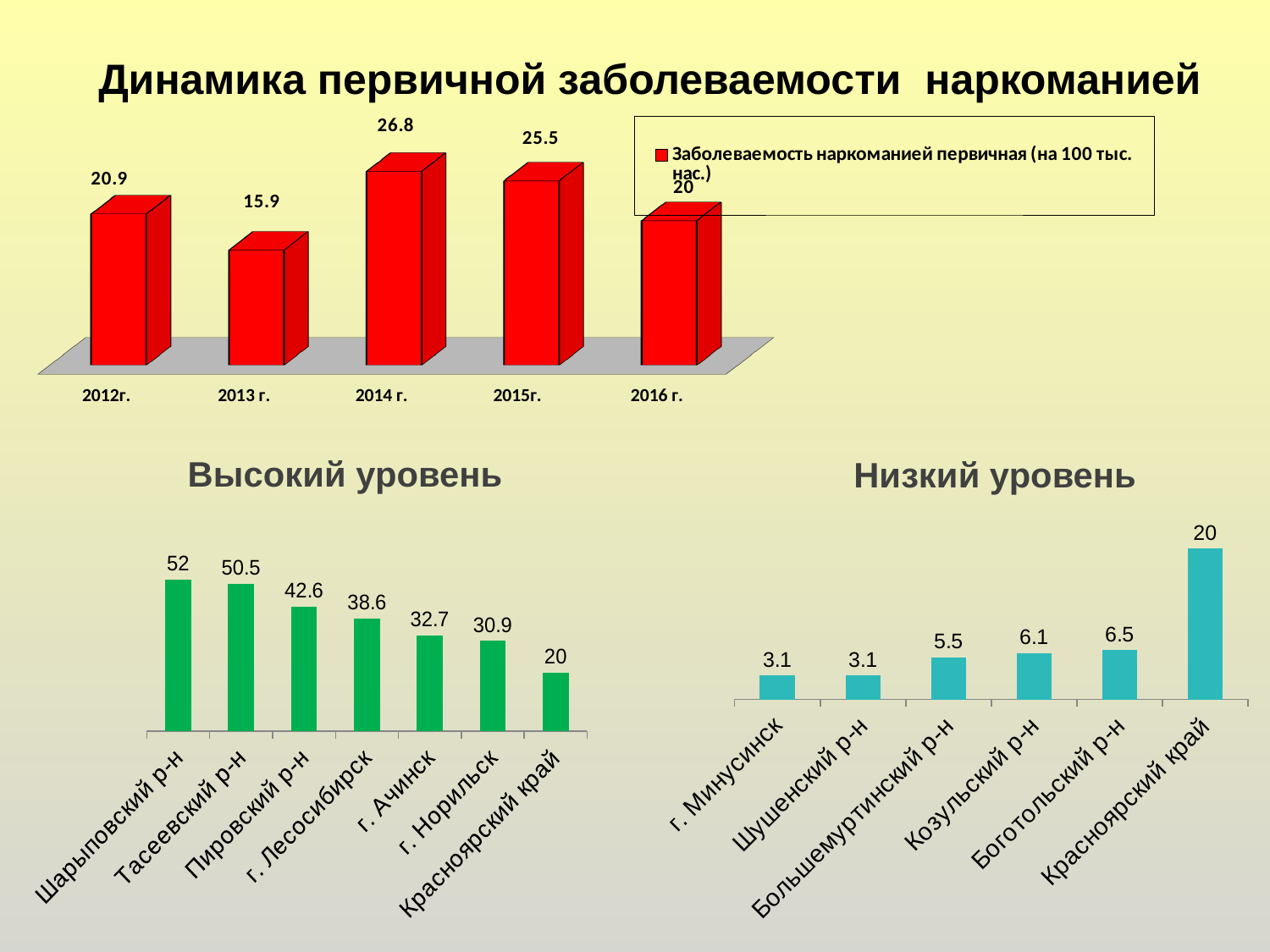
In the top chart, what is the value for 2014 г.? 26.8 In the top chart, how many series does the legend list? 1 In the 'Высокий уровень' chart, do the values rise or fall from left to right along the x axis? fall In the top chart, what is the difference between the values for 2014 г. and 2013 г.? 10.9 In the 'Низкий уровень' chart, which category has the highest value? Красноярский край In the top chart, which year has the lowest value? 2013 г. What kind of chart is the 'Низкий уровень' chart? bar chart In the 'Высокий уровень' chart, which category has the highest value? Шарыповский р-н In the 'Низкий уровень' chart, what is the value for Козульский р-н? 6.1 In the 'Низкий уровень' chart, which is larger, the value for Большемуртинский р-н or Боготольский р-н? Боготольский р-н In the top chart, how many years are shown on the x axis? 5 In the 'Высокий уровень' chart, what is the value for Пировский р-н? 42.6